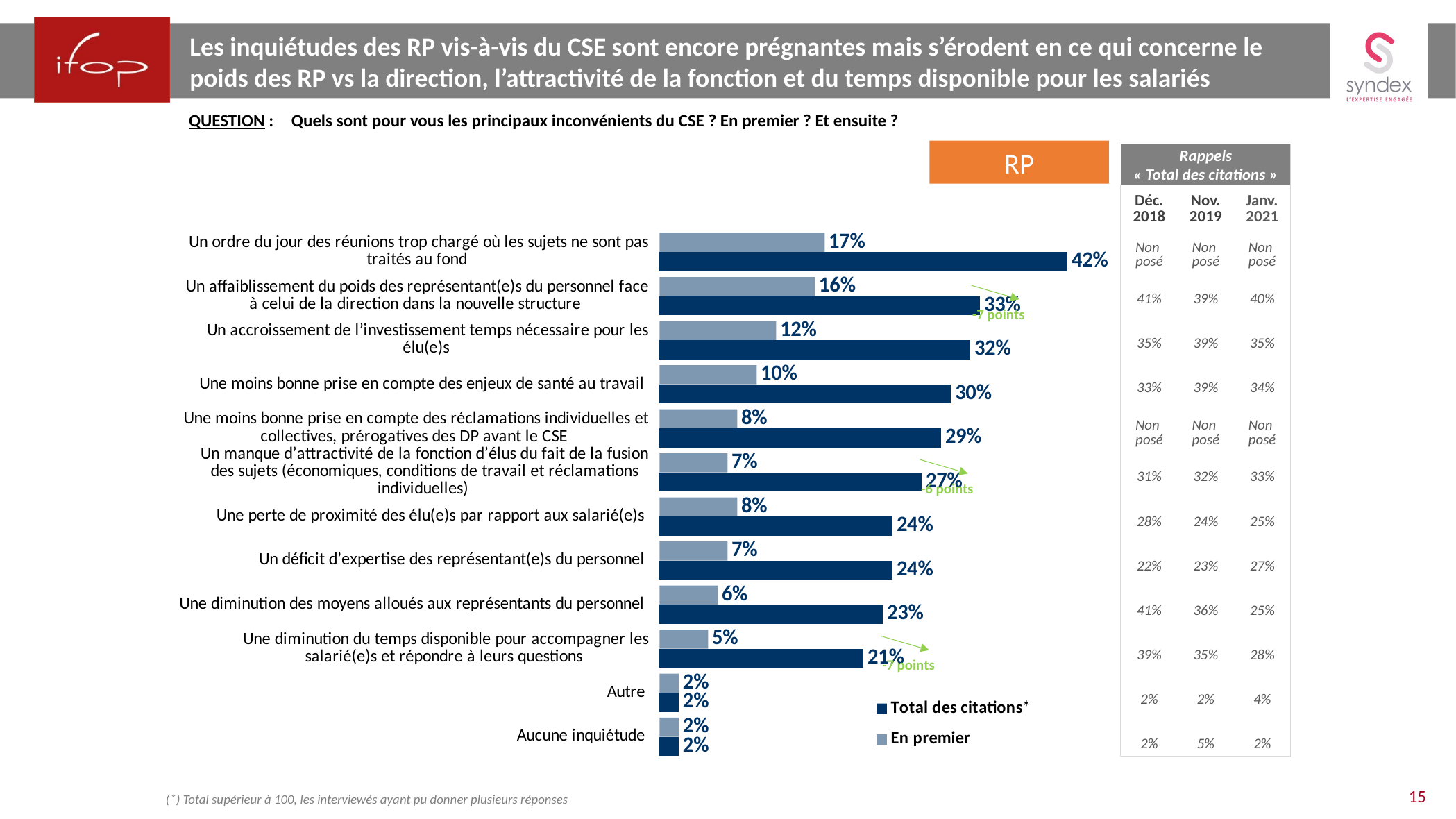
Which is larger: the 'Total des citations*' value for 'Un accroissement de l'investissement temps nécessaire pour les élu(e)s' or for 'Une perte de proximité des élu(e)s par rapport aux salarié(e)s'? Un accroissement de l'investissement temps nécessaire pour les élu(e)s What is the 'Total des citations*' value for 'Une diminution des moyens alloués aux représentants du personnel'? 23% What is the 'En premier' value for 'Une moins bonne prise en compte des enjeux de santé au travail'? 10% Which category has the lowest 'En premier' value among the ten substantive concerns (excluding 'Autre' and 'Aucune inquiétude')? Une diminution du temps disponible pour accompagner les salarié(e)s et répondre à leurs questions How many series does the chart legend list? 2 What is the 'Total des citations*' value for 'Un ordre du jour des réunions trop chargé où les sujets ne sont pas traités au fond'? 42% Which category has the highest 'Total des citations*' value? Un ordre du jour des réunions trop chargé où les sujets ne sont pas traités au fond What is the difference between the 'Total des citations*' and 'En premier' values for 'Un affaiblissement du poids des représentant(e)s du personnel face à celui de la direction dans la nouvelle structure'? 17 percentage points How many categories are shown in the bar chart? 12 What are the two series named in the chart legend? Total des citations* and En premier What is the 'En premier' value for 'Un déficit d'expertise des représentant(e)s du personnel'? 7% What type of chart is shown on the slide? Bar chart